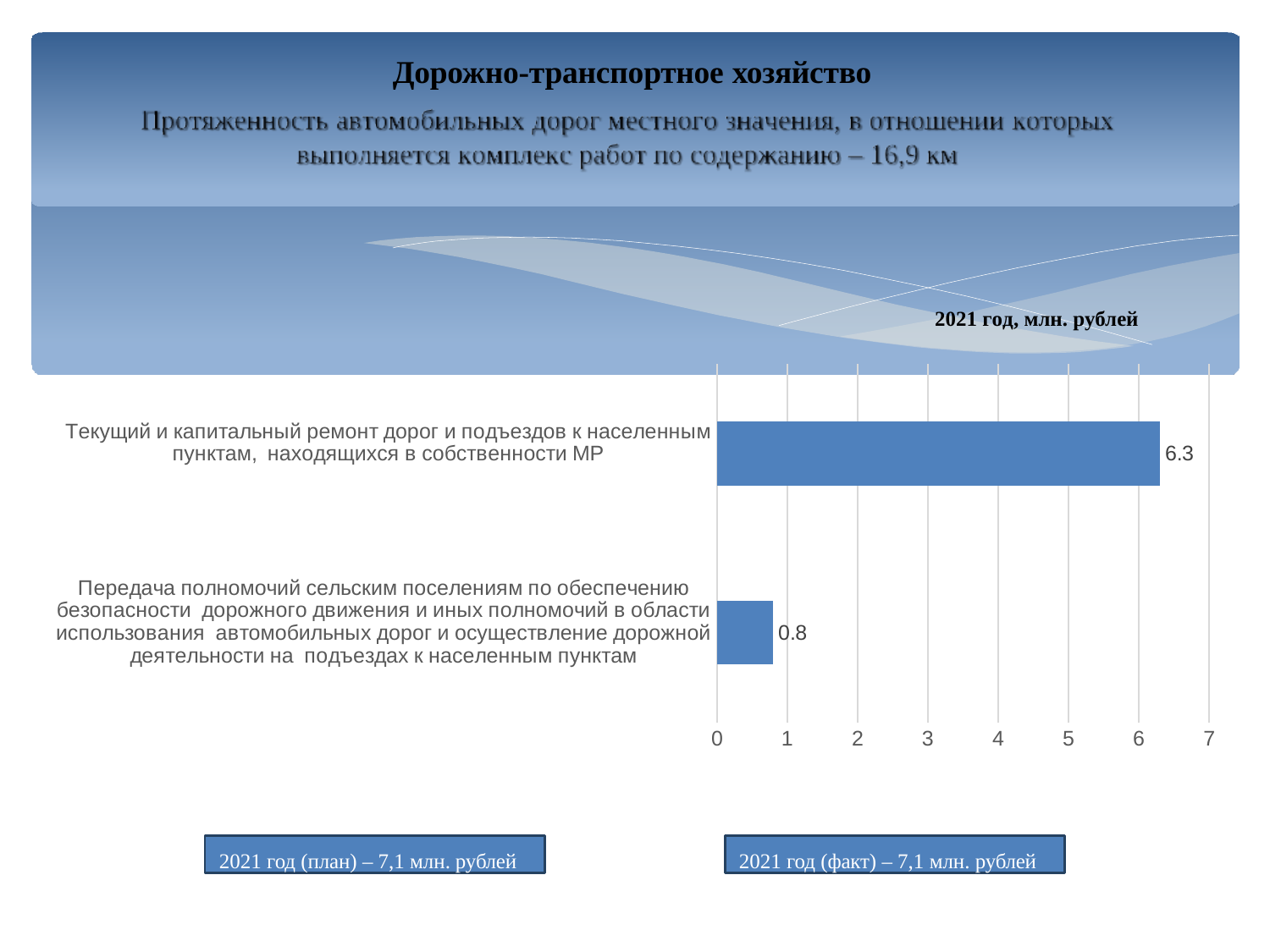
Which is larger: the value for "Текущий и капитальный ремонт дорог..." or the value for "Передача полномочий сельским поселениям..."? Текущий и капитальный ремонт дорог... Is the value for "Текущий и капитальный ремонт дорог..." greater or less than 5? greater What is the value for "Текущий и капитальный ремонт дорог и подъездов к населенным пунктам, находящихся в собственности МР"? 6.3 What is the maximum value shown on the horizontal axis of the chart? 7 What is the difference between the value for "Текущий и капитальный ремонт дорог..." and the value for "Передача полномочий сельским поселениям..."? 5.5 How many categories are shown in the chart? 2 What kind of chart is shown on the slide? bar chart What is the value for "Передача полномочий сельским поселениям по обеспечению безопасности дорожного движения..."? 0.8 Which category has the highest value? Текущий и капитальный ремонт дорог и подъездов к населенным пунктам, находящихся в собственности МР What is the title of the chart? 2021 год, млн. рублей Is the value for "Передача полномочий сельским поселениям..." greater or less than 1? less